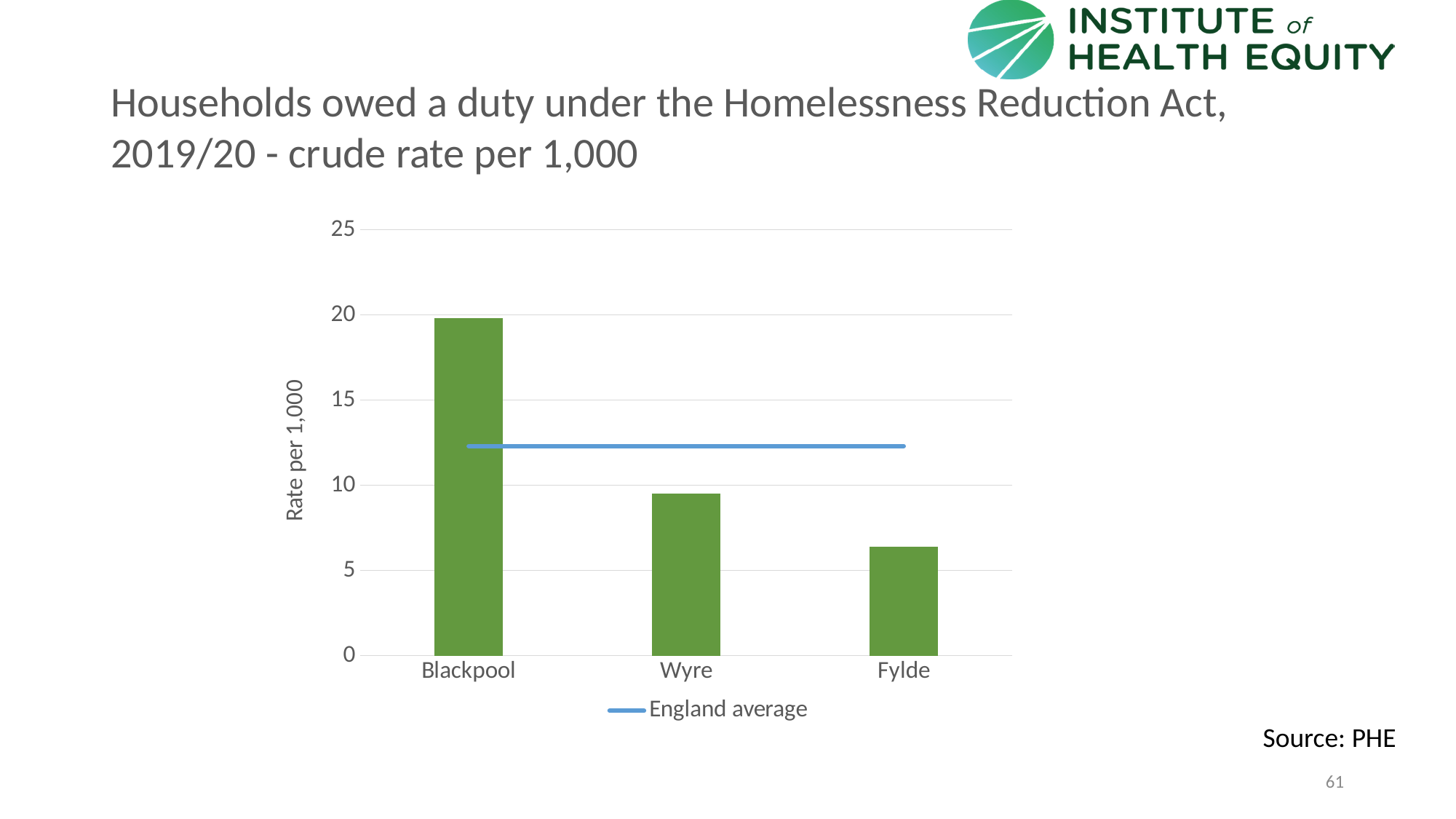
Is the value for Blackpool greater or less than 15? greater Which area has the highest rate of households owed a duty under the Homelessness Reduction Act? Blackpool Which has a higher rate, Wyre or Fylde? Wyre How many areas are shown as bars on the chart? 3 Is the value for Wyre greater or less than 10? less Which has a higher rate, Blackpool or Wyre? Blackpool What does the blue horizontal line on the chart represent, according to the legend? England average What kind of chart is shown on the slide? Bar chart Which area has the lowest rate of households owed a duty under the Homelessness Reduction Act? Fylde What is the label on the vertical axis of the chart? Rate per 1,000 Is the value for Fylde greater or less than 5? greater